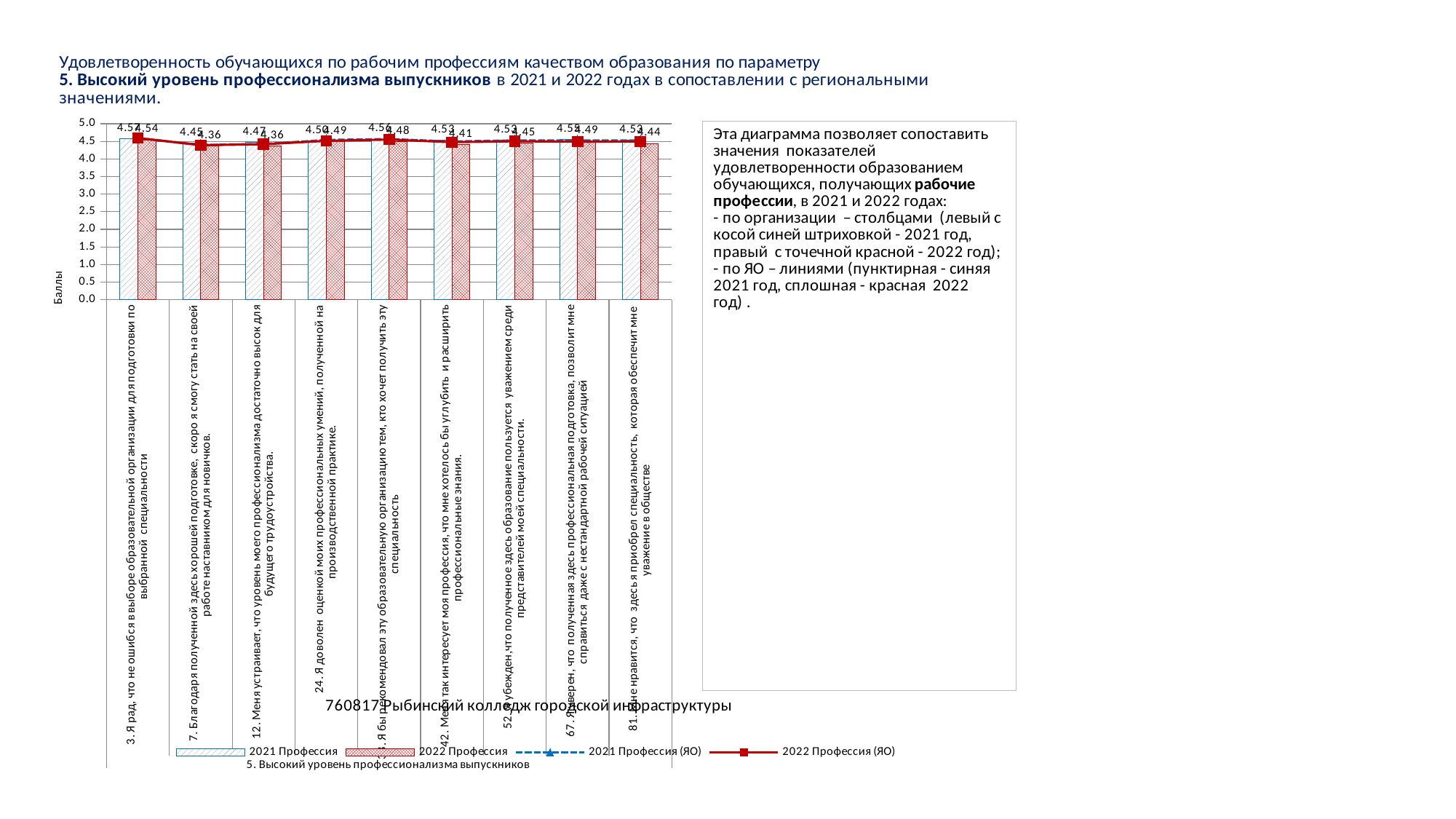
What is the maximum value shown on the chart's y axis? 5.0 Which is larger: the first data label for category 3 (4.57) or the first data label for category 7 (4.45)? 4.57 (category 3) How many series does the chart legend list? 4 What is the first (left) data label shown for category 3 ("Я рад, что не ошибся в выборе образовательной организации...")? 4.57 What is the difference between the two data labels shown for category 3 (4.57 and 4.54)? 0.03 Is the value for category 42 ("Меня так интересует моя профессия...") greater or less than 4.0? greater What is the title of the chart's y axis? Баллы What is the highest data label value shown anywhere on the chart? 4.57 What type of chart is shown on the slide? Combined bar and line chart What is the second (right) data label shown for category 7 ("Благодаря полученной здесь хорошей подготовке...")? 4.36 What is the first (left) data label shown for category 24 ("Я доволен оценкой моих профессиональных умений...")? 4.50 How many categories (questions) are plotted along the x axis of the chart? 9